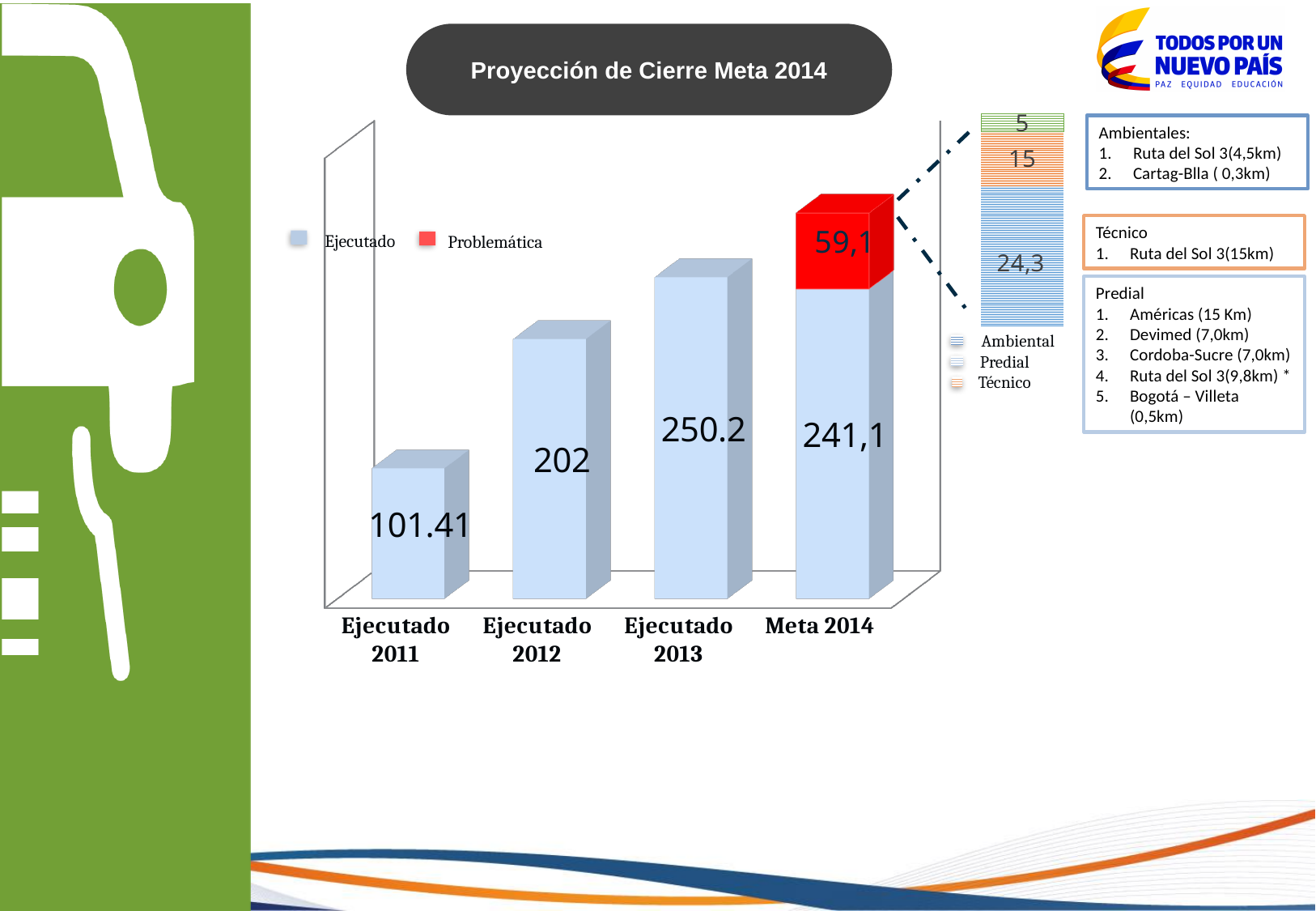
What is the title of the chart on the slide? Proyección de Cierre Meta 2014 In the main chart, what is the value shown for Ejecutado 2013? 250.2 In the main chart, what is the value shown for Ejecutado 2012? 202 In the main chart, what is the total of the stacked Meta 2014 bar (Ejecutado plus Problemática)? 300,2 In the small breakdown bar of the Problemática segment, what is the value for Predial? 24,3 What type of chart is the main chart on the slide? bar chart How many categories are shown on the x axis of the main chart? 4 How many series does the legend of the main chart list? 2 In the main chart, what is the Ejecutado value for Ejecutado 2011? 101.41 In the main chart, which is larger: the Ejecutado value for Ejecutado 2013 or the Ejecutado value for Meta 2014? Ejecutado 2013 In the main chart, what is the Problemática value for Meta 2014? 59,1 In the main chart, what is the difference between the Ejecutado 2013 value and the Ejecutado 2012 value? 48.2